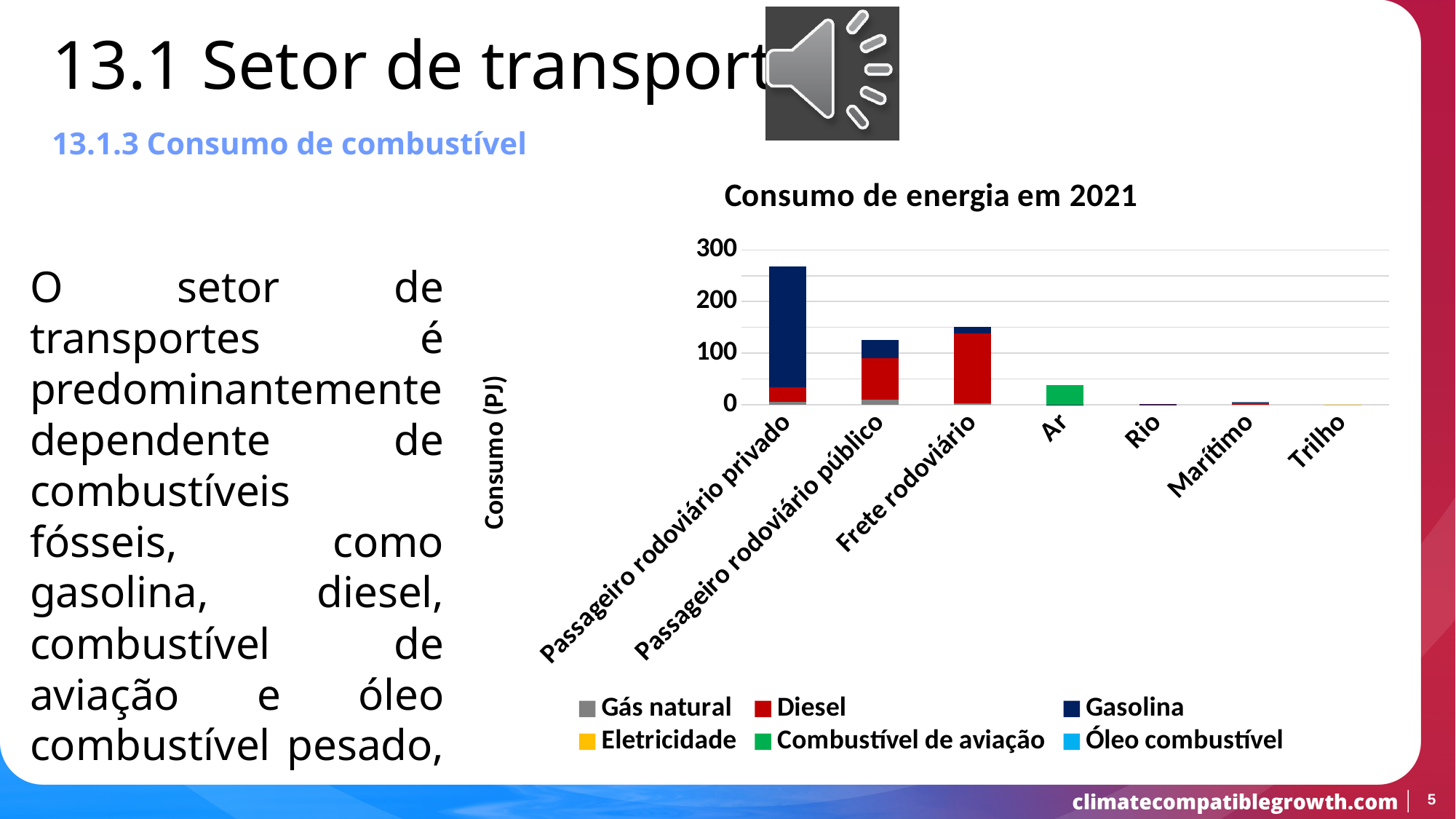
Which category has the highest total energy consumption in the chart? Passageiro rodoviário privado Is the total value for Passageiro rodoviário público greater or less than 100? greater How many series does the chart legend list? 6 Is the total value for Frete rodoviário greater or less than 200? less What is the label of the y axis of the chart? Consumo (PJ) Which has a larger total consumption, Frete rodoviário or Ar? Frete rodoviário Is the total value for Passageiro rodoviário privado greater or less than 200? greater What is the title of the chart? Consumo de energia em 2021 How many categories are shown on the x axis of the chart? 7 What kind of chart is shown on the slide? Stacked bar chart Which has a larger total consumption, Passageiro rodoviário privado or Passageiro rodoviário público? Passageiro rodoviário privado